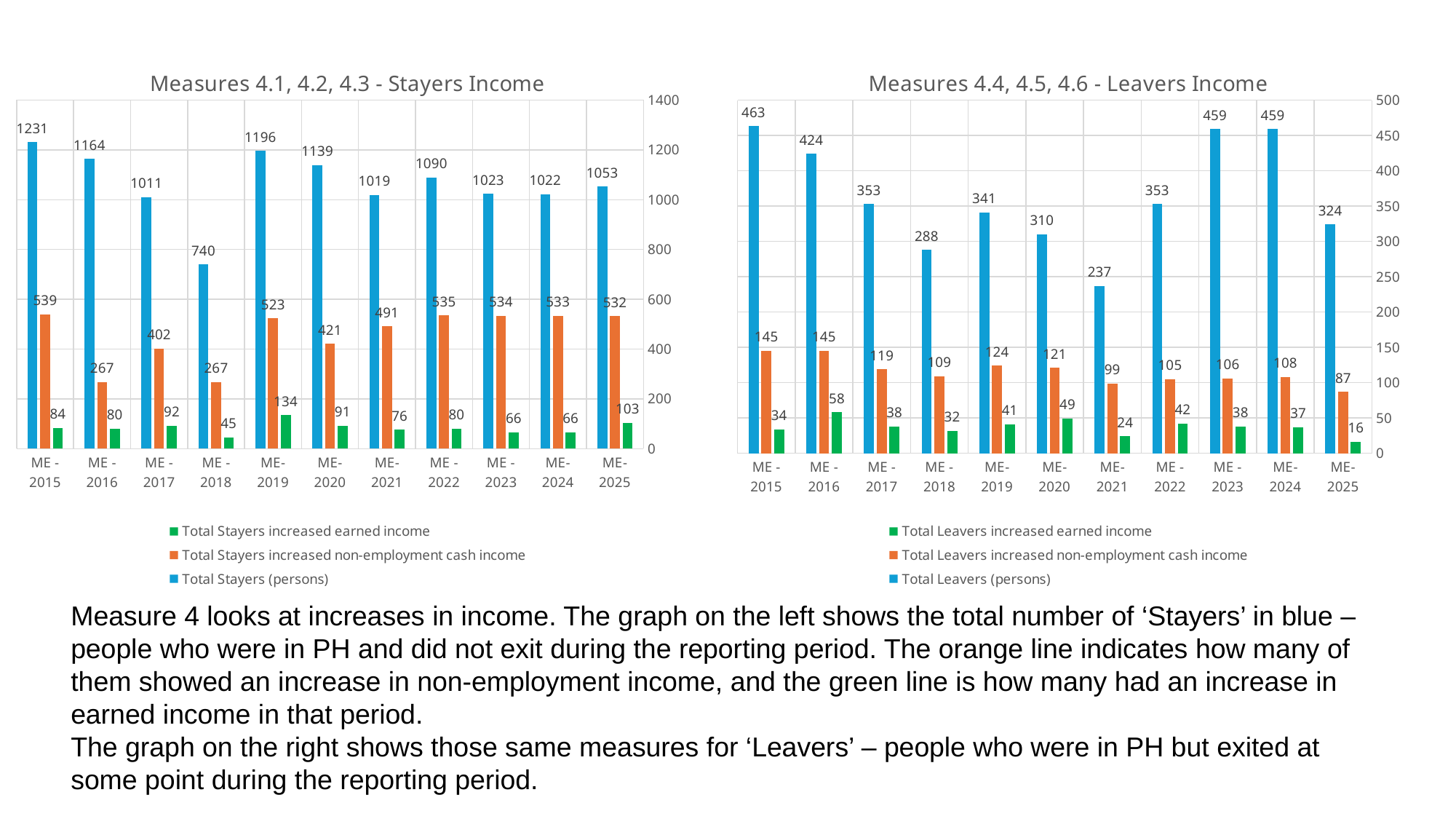
In the 'Measures 4.1, 4.2, 4.3 - Stayers Income' chart, what is the difference between Total Stayers increased non-employment cash income in ME - 2015 and ME - 2016? 272 In the 'Measures 4.1, 4.2, 4.3 - Stayers Income' chart, what is the value of Total Stayers (persons) for ME - 2015? 1231 In the 'Measures 4.4, 4.5, 4.6 - Leavers Income' chart, which is larger: Total Leavers increased non-employment cash income in ME - 2019 or in ME - 2020? ME - 2019 In the 'Measures 4.1, 4.2, 4.3 - Stayers Income' chart, which year has the lowest value for Total Stayers (persons)? ME - 2018 In the 'Measures 4.1, 4.2, 4.3 - Stayers Income' chart, how many series does the legend list? 3 In the 'Measures 4.4, 4.5, 4.6 - Leavers Income' chart, what is the value of Total Leavers (persons) for ME - 2021? 237 What type of chart is the 'Measures 4.4, 4.5, 4.6 - Leavers Income' chart? Bar chart In the 'Measures 4.1, 4.2, 4.3 - Stayers Income' chart, which year has the highest value for Total Stayers increased earned income? ME - 2019 In the 'Measures 4.4, 4.5, 4.6 - Leavers Income' chart, which year has the lowest value for Total Leavers increased earned income? ME - 2025 In the 'Measures 4.4, 4.5, 4.6 - Leavers Income' chart, how many years are shown on the x axis? 11 In the 'Measures 4.4, 4.5, 4.6 - Leavers Income' chart, which year has the highest value for Total Leavers (persons)? ME - 2015 In the 'Measures 4.4, 4.5, 4.6 - Leavers Income' chart, what colour represents Total Leavers (persons)? Blue